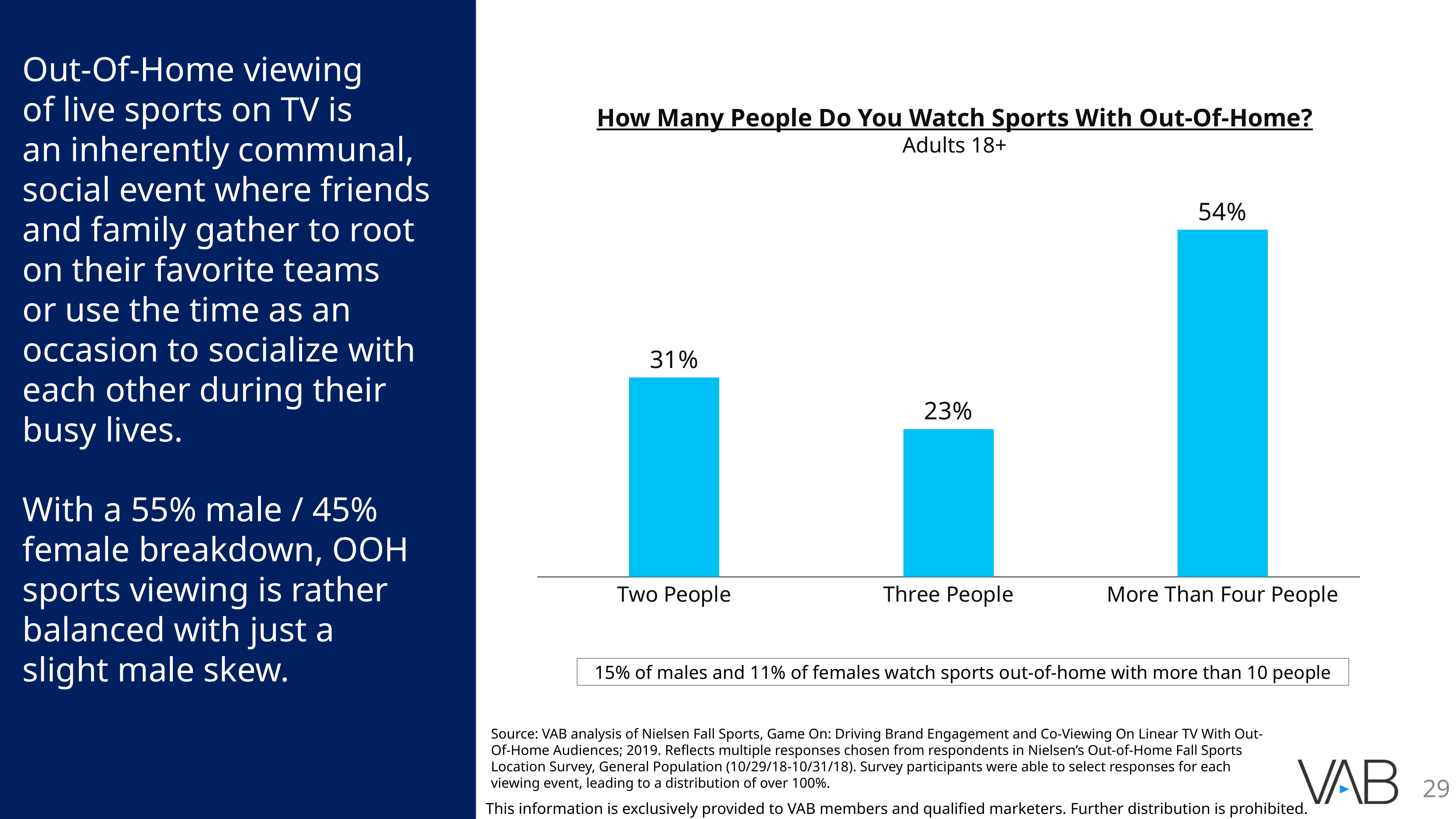
What is the title of the chart? How Many People Do You Watch Sports With Out-Of-Home? What is the difference between the values for Two People and Three People? 8% What percentage of adults 18+ watch sports out-of-home with two people? 31% What audience group does the chart subtitle say the data covers? Adults 18+ What is the difference between the values for More Than Four People and Two People? 23% What is the value shown for More Than Four People? 54% Which category has the highest value? More Than Four People How many categories are shown on the x axis of the chart? 3 What kind of chart is shown on the slide? Bar chart Which is larger, the value for Two People or the value for Three People? Two People What is the value shown for Three People? 23% Which category has the lowest value? Three People